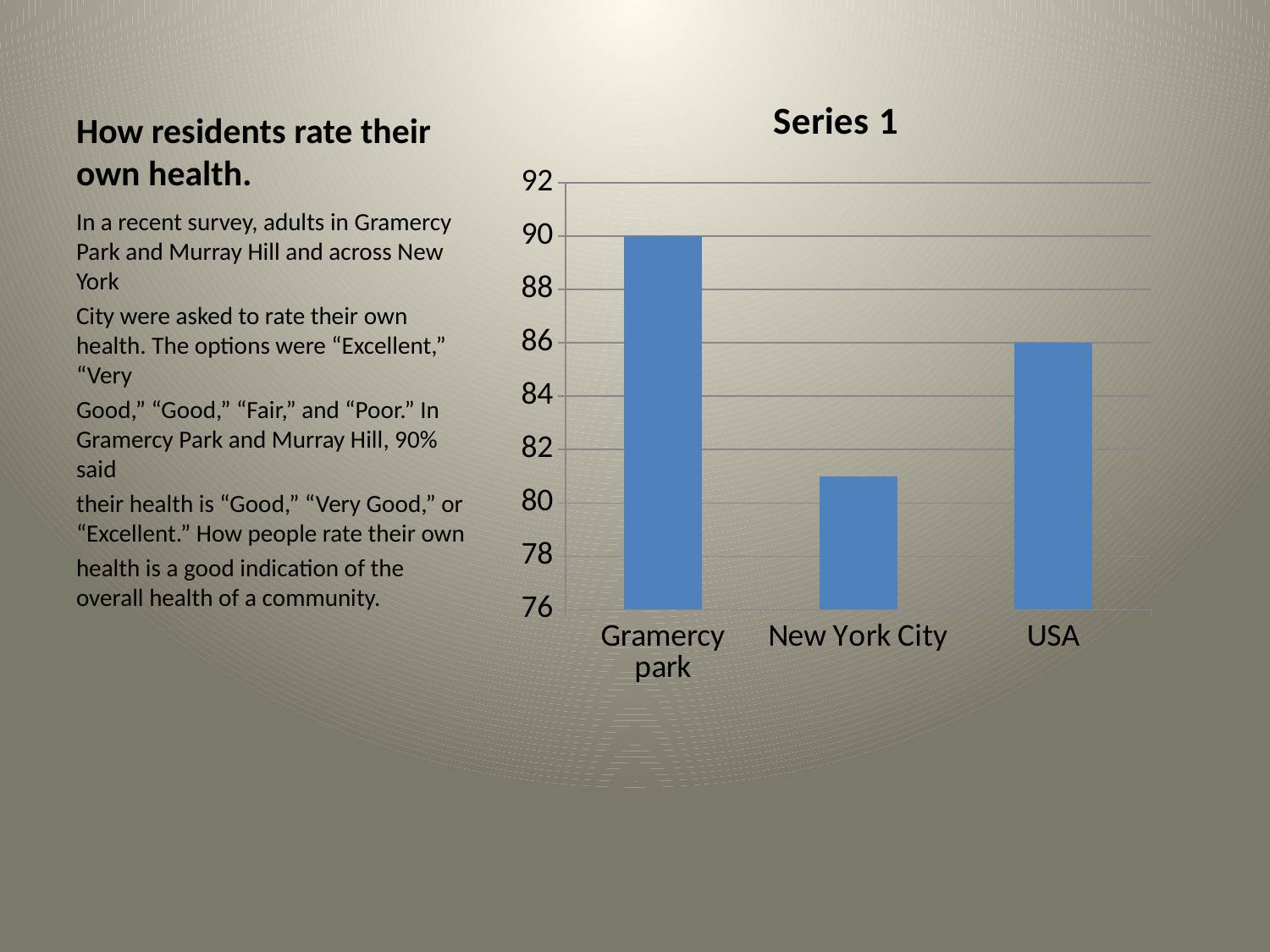
What is the value for USA? 86 What is the title of the chart? Series 1 What kind of chart is shown on the slide? bar chart What is the difference between the values for Gramercy park and USA? 4 Is the value for USA greater or less than 84? greater Which category has the lowest value? New York City What is the value for Gramercy park? 90 Is the value for New York City greater or less than 80? greater Which category has the highest value? Gramercy park How many categories are shown on the x axis? 3 Is the value for New York City greater or less than 82? less Which is larger, the value for USA or the value for New York City? USA